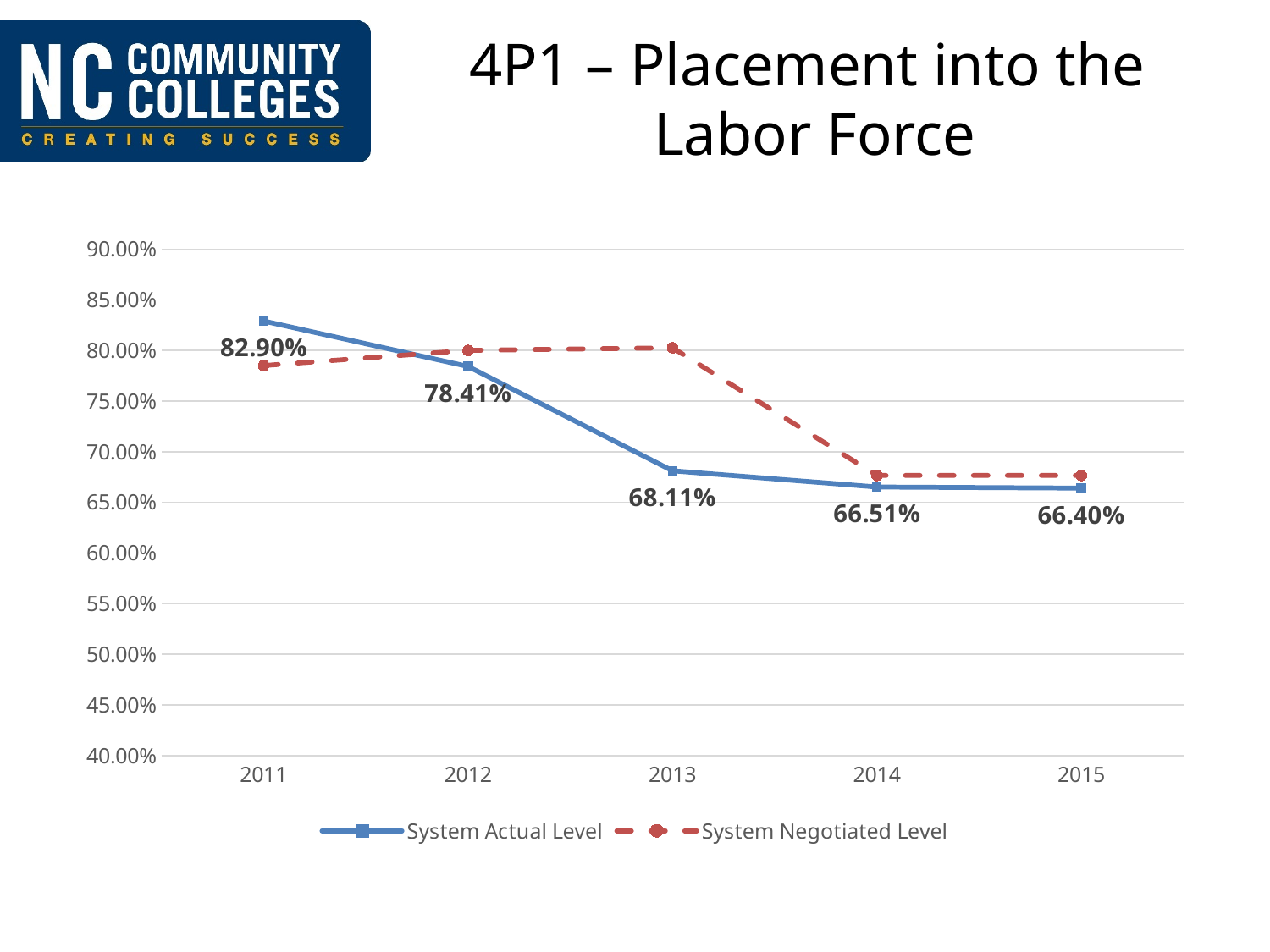
What is the difference between the System Actual Level in 2011 and in 2012? 4.49% How many years are shown on the x axis? 5 In 2013, which is larger: the System Actual Level or the System Negotiated Level? System Negotiated Level Is the System Negotiated Level for 2013 greater or less than 75.00%? greater What is the System Actual Level for 2013? 68.11% In 2011, which is larger: the System Actual Level or the System Negotiated Level? System Actual Level What is the System Actual Level for 2011? 82.90% In which year is the System Actual Level lowest? 2015 Is the System Negotiated Level for 2014 greater or less than 70.00%? less What is the System Actual Level for 2015? 66.40% How many series does the legend list? 2 In which year is the System Actual Level highest? 2011